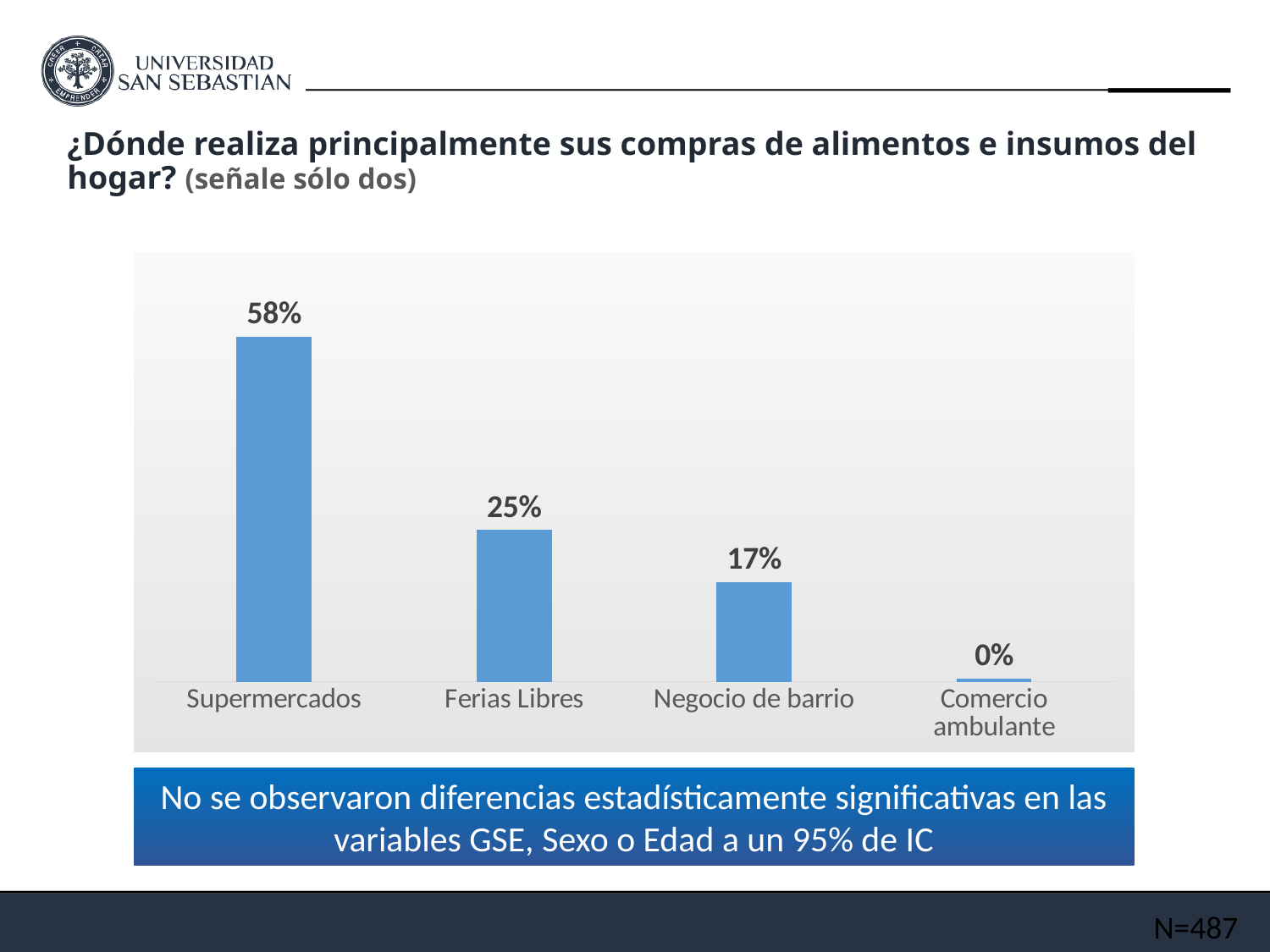
What is the difference between the values for Ferias Libres and Negocio de barrio? 8% What is the value for Supermercados? 58% What kind of chart is shown on the slide? Bar chart Which is larger, the value for Ferias Libres or the value for Negocio de barrio? Ferias Libres What is the value for Ferias Libres? 25% Which category has the lowest value? Comercio ambulante What is the value for Comercio ambulante? 0% What is the value for Negocio de barrio? 17% How many categories are shown in the chart? 4 Which category has the highest value? Supermercados Do the values rise or fall from left to right across the categories? Fall What is the difference between the values for Supermercados and Ferias Libres? 33%